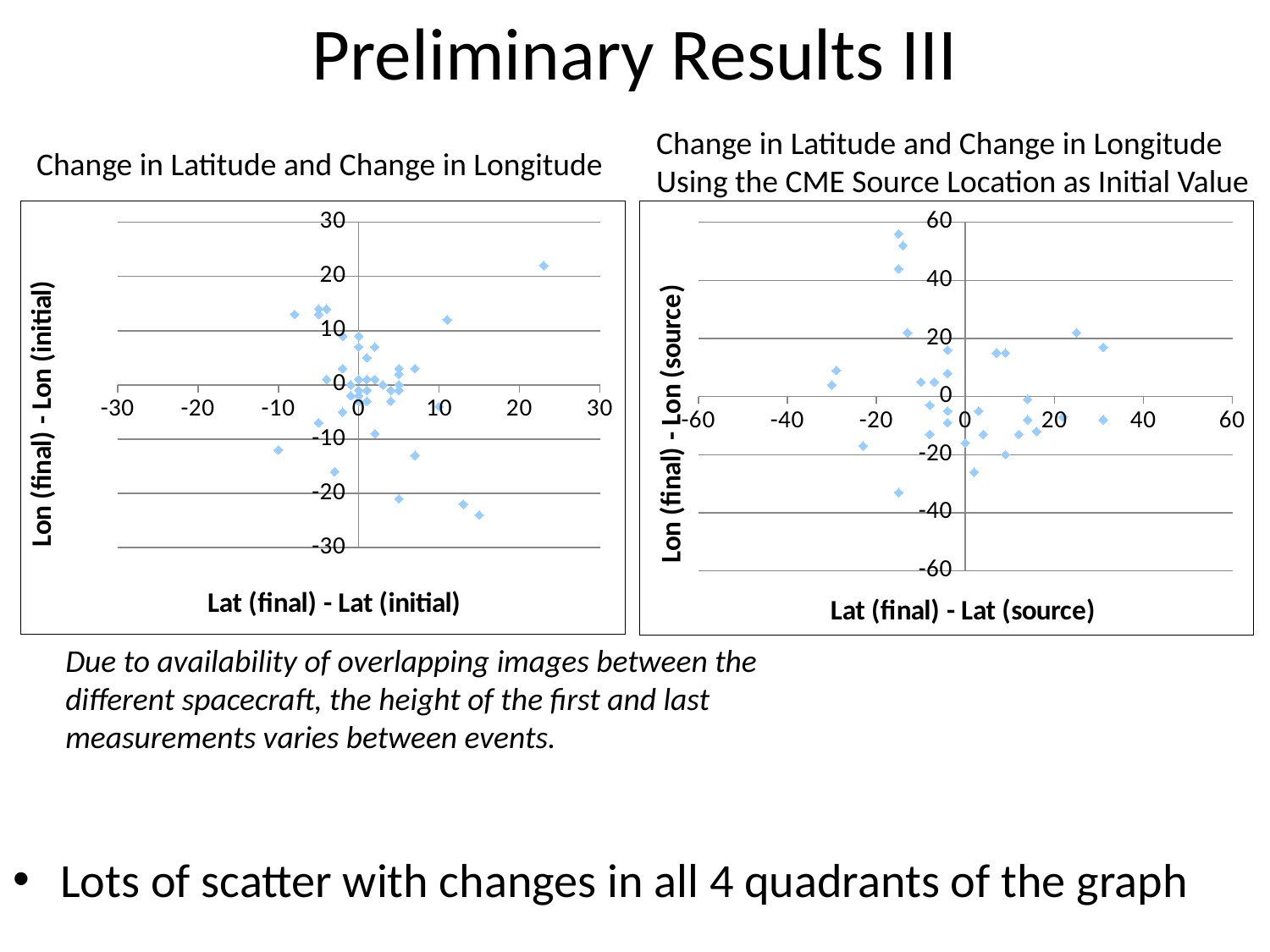
In the right chart, what is the y-axis title? Lon (final) - Lon (source) In the right chart, is the x value of the leftmost point greater or less than -20? less In the left chart, is the y value of the lowest point greater or less than -20? less In the right chart, is the y value of the lowest point greater or less than -20? less What kind of chart is the right chart titled "Change in Latitude and Change in Longitude Using the CME Source Location as Initial Value"? scatter chart What is the maximum value shown on the y axis of the right chart? 60 In the left chart, is the y value of the highest point greater or less than the y value of the highest point in the right chart? less What kind of chart is the left chart titled "Change in Latitude and Change in Longitude"? scatter chart In the left chart, what is the x-axis title? Lat (final) - Lat (initial)